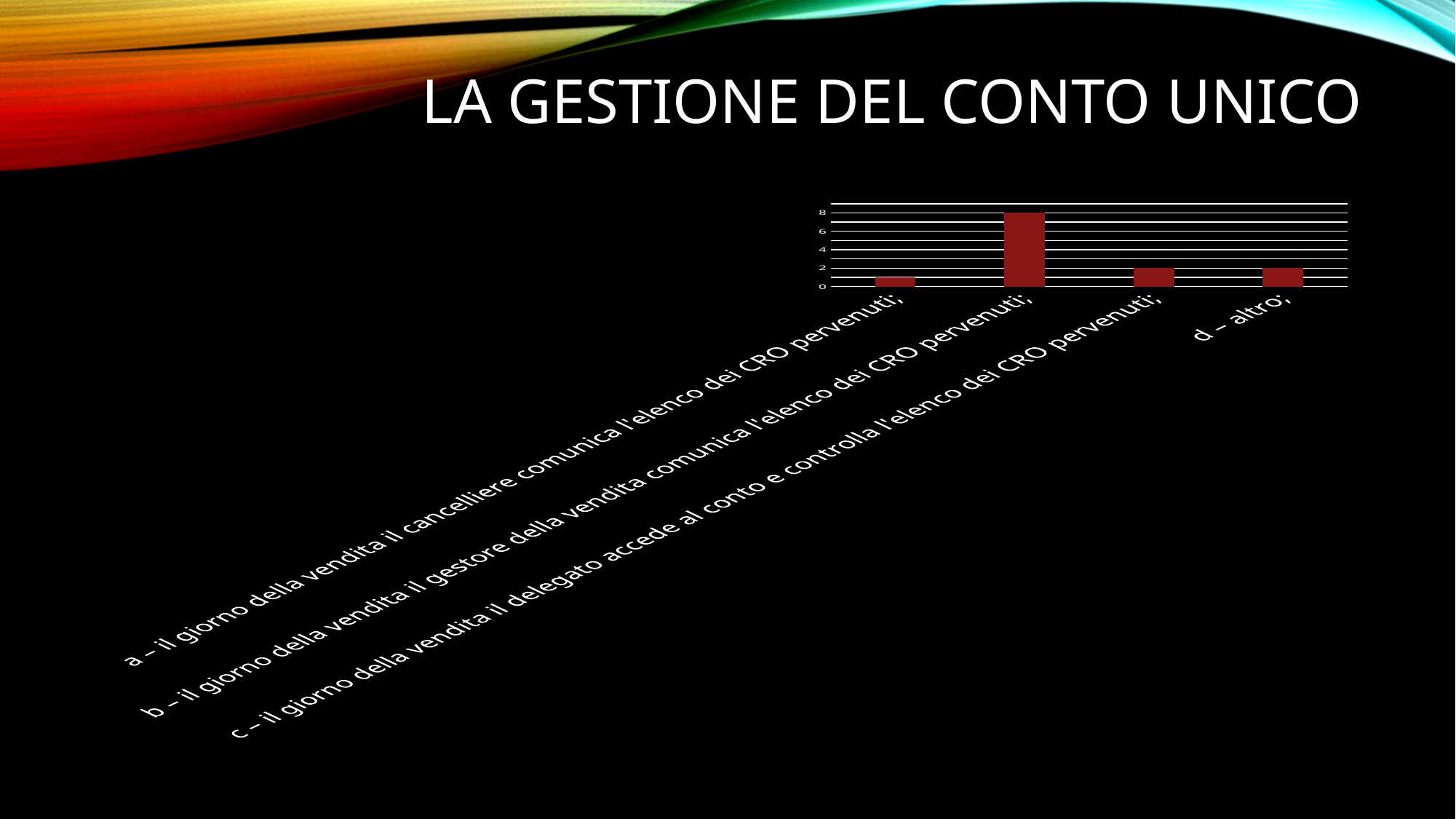
What is the title of the slide containing the chart? LA GESTIONE DEL CONTO UNICO Which category has the lowest bar? a – il giorno della vendita il cancelliere comunica l'elenco dei CRO pervenuti; What kind of chart is shown on the slide? bar chart How many categories does the chart show? 4 What is the value for category b (il gestore della vendita comunica l'elenco dei CRO pervenuti)? 8 Which category has the highest bar? b – il giorno della vendita il gestore della vendita comunica l'elenco dei CRO pervenuti; What is the difference between the value for category b and the value for category d – altro? 6 Is the value for category a greater or less than 2? less What is the value for category c (il delegato accede al conto e controlla l'elenco dei CRO pervenuti)? 2 What is the value for category d – altro? 2 Which is larger, the value for category b or the value for category c? b What is the highest value shown on the vertical axis? 8